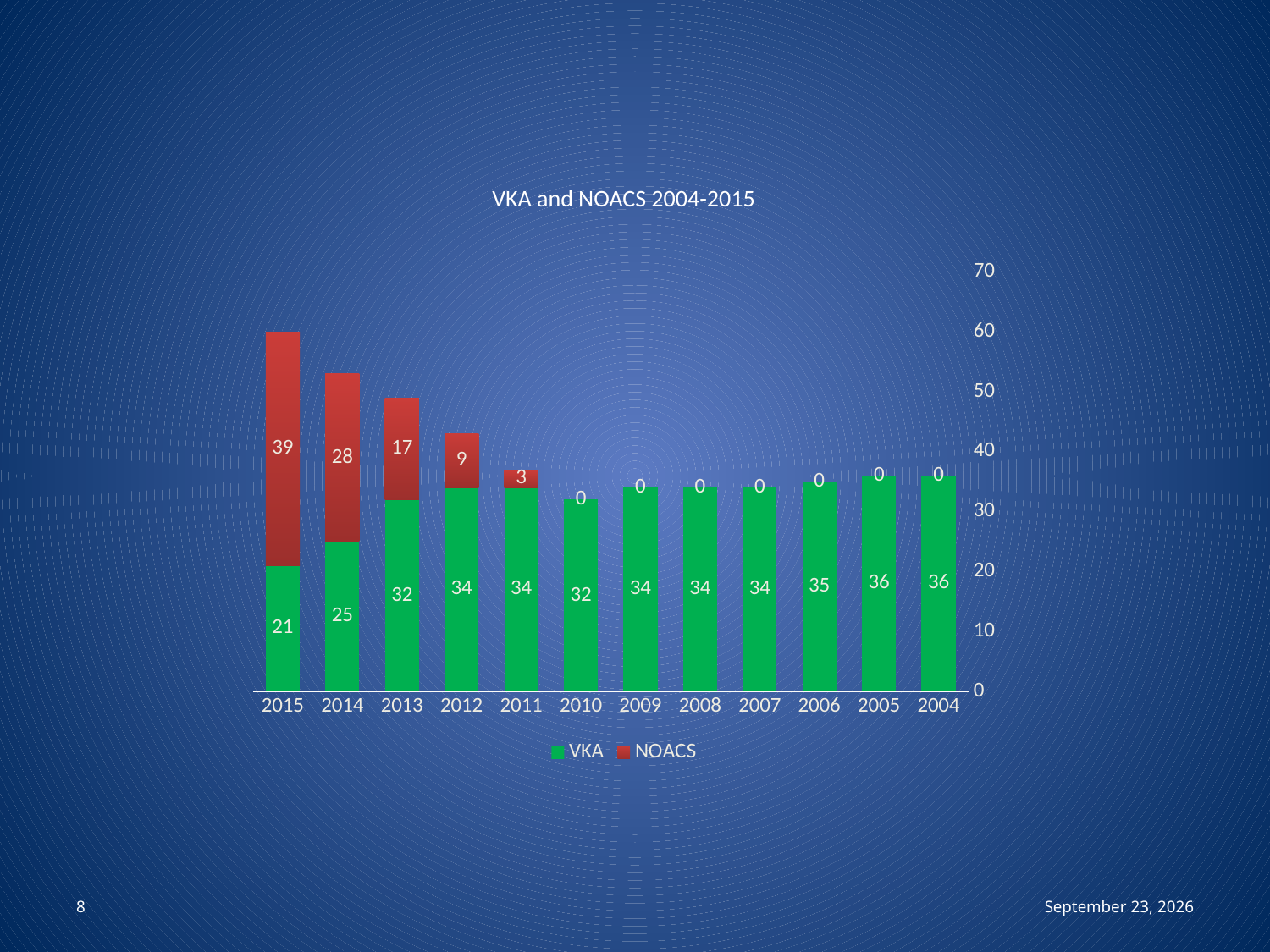
Which year has the lowest VKA value? 2015 What is the NOACS value for 2012? 9 How many series does the legend list? 2 What is the total of the stacked bar for 2015? 60 Which year has the highest NOACS value? 2015 What is the difference between the NOACS values for 2015 and 2013? 22 What is the VKA value for 2015? 21 How many years are shown on the x axis? 12 Which is larger, the VKA value for 2014 or the VKA value for 2010? 2010 What kind of chart is shown? Stacked bar chart What is the NOACS value for 2014? 28 What is the total of the stacked bar for 2013? 49